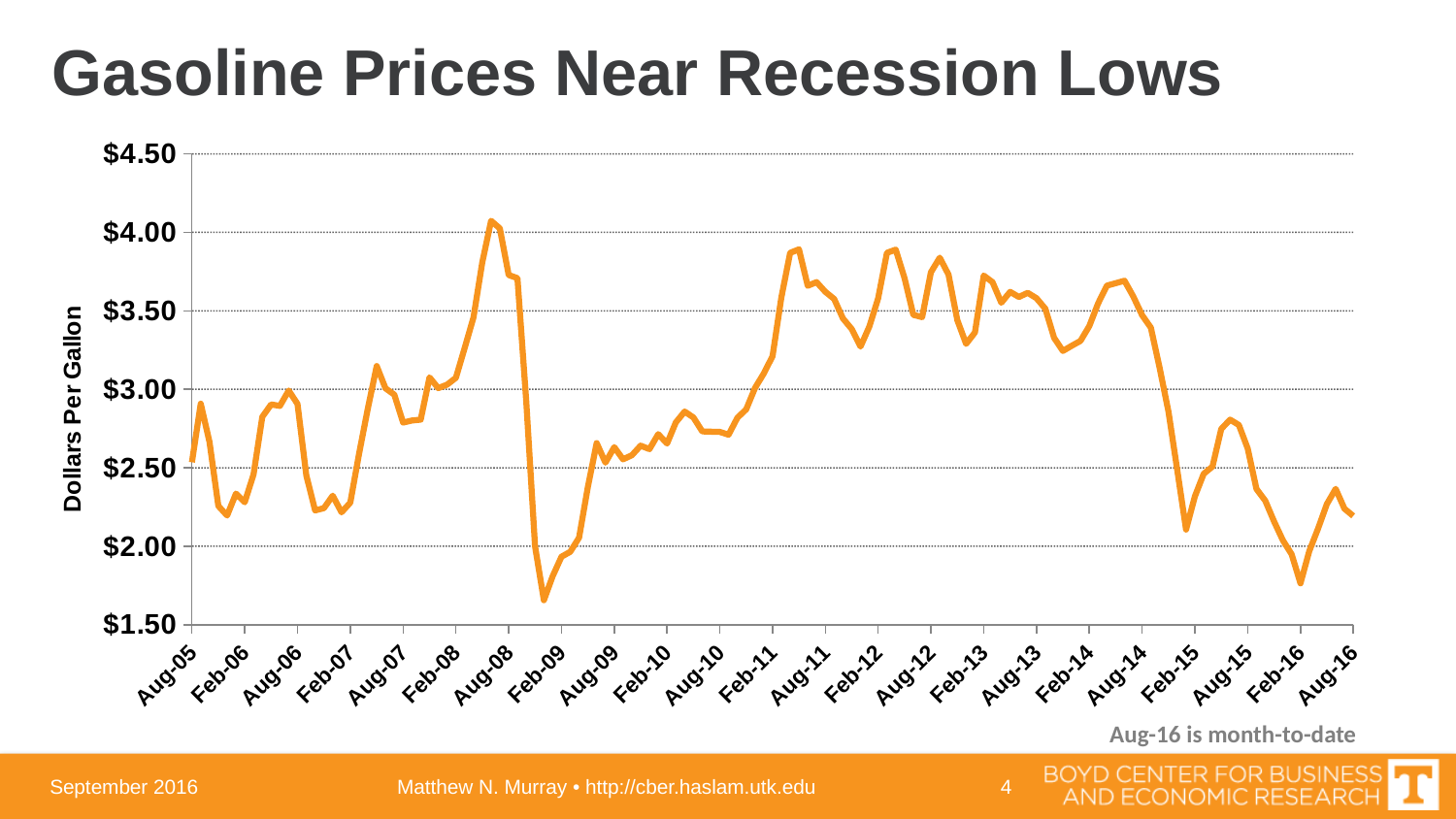
Does the line rise or fall between Aug-14 and Feb-15? fall Is the value for Feb-14 greater or less than $3.50? less Is the value for Feb-09 greater or less than $2.00? less Is the value for Aug-10 greater or less than $3.00? less What kind of chart is shown on the slide? line chart Which is larger, the value for Aug-08 or the value for Feb-09? Aug-08 What is the label on the vertical axis of the chart? Dollars Per Gallon Around which x-axis label does the line reach its highest point? Aug-08 What is the title of the chart on the slide? Gasoline Prices Near Recession Lows